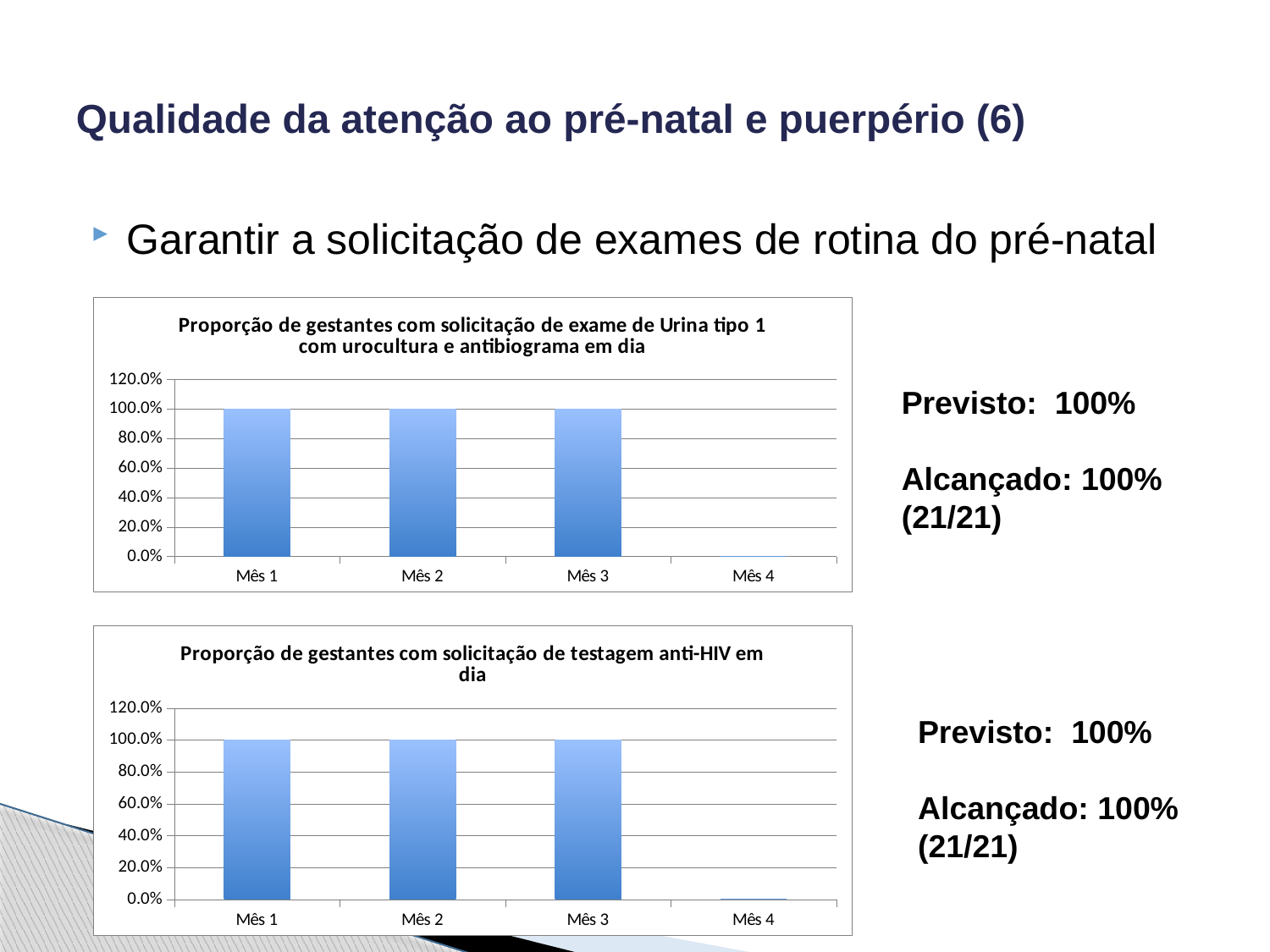
In the bottom chart (testagem anti-HIV), what is the difference between the values for Mês 1 and Mês 3? 0.0% What is the title of the bottom chart? Proporção de gestantes com solicitação de testagem anti-HIV em dia What type of chart is the top chart, 'Proporção de gestantes com solicitação de exame de Urina tipo 1 com urocultura e antibiograma em dia'? bar chart In the top chart (Urina tipo 1), is the value for Mês 4 greater or less than 20.0%? less In the bottom chart (testagem anti-HIV), what is the value for Mês 2? 100.0% In the bottom chart (testagem anti-HIV), what is the highest value shown on the y axis? 120.0% In the top chart (Urina tipo 1), what is the value for Mês 1? 100.0% In the bottom chart (testagem anti-HIV), is the value for Mês 4 greater or less than 20.0%? less In the top chart (Urina tipo 1), how many month categories are shown on the x axis? 4 In the bottom chart (testagem anti-HIV), which is larger, the value for Mês 1 or the value for Mês 4? Mês 1 In the top chart (Urina tipo 1), what is the value for Mês 3? 100.0% In the top chart (Urina tipo 1), which month has the lowest value? Mês 4